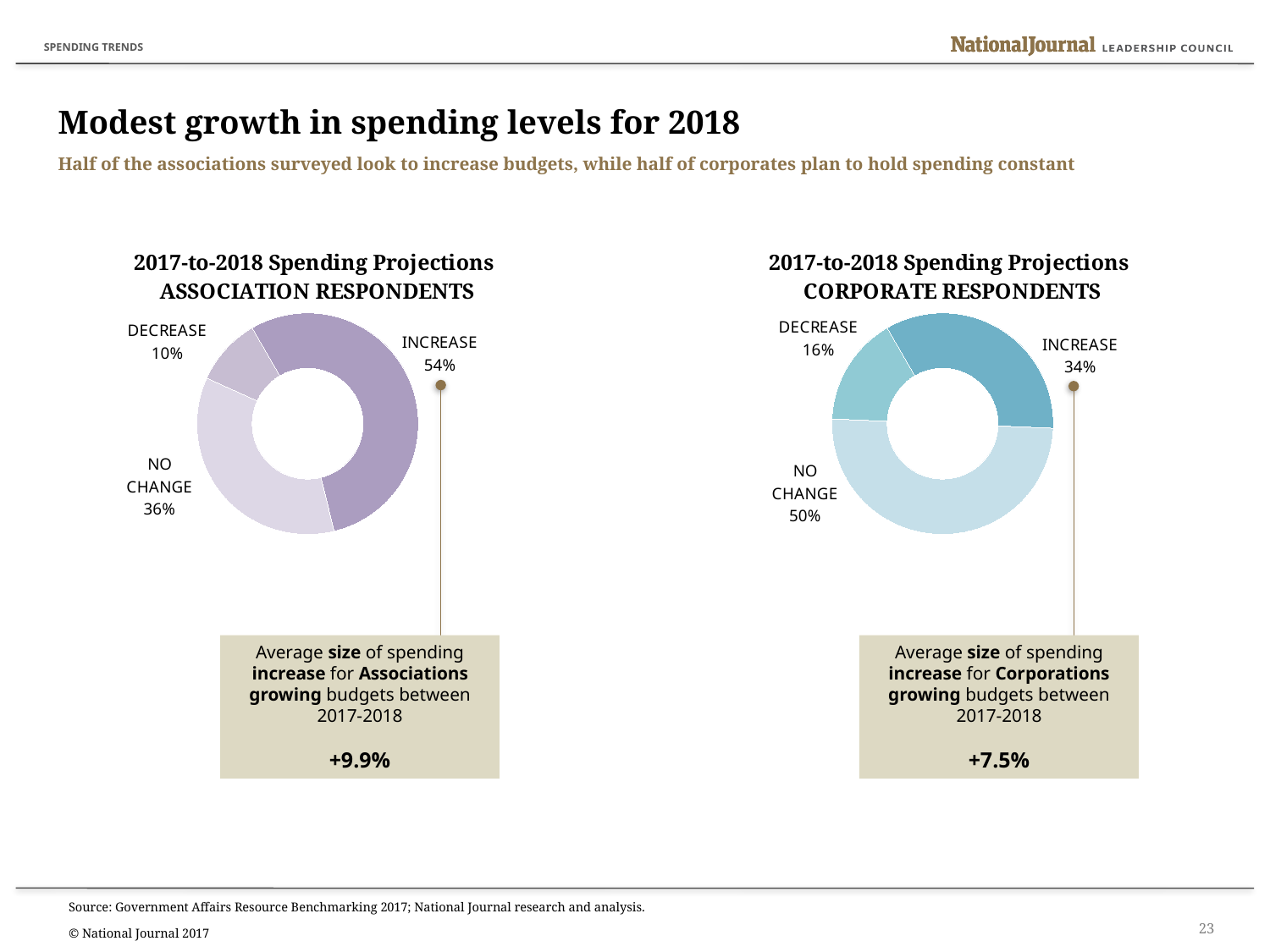
How many categories does the Association Respondents chart show? 3 In the Corporate Respondents chart, what share of respondents project no change in spending? 50% In the Corporate Respondents chart, what is the difference in percentage points between the NO CHANGE and INCREASE shares? 16 What is the average size of spending increase for Associations growing budgets between 2017-2018, as shown below the Association Respondents chart? +9.9% In the Association Respondents chart, what share of respondents project a decrease in spending? 10% In the Corporate Respondents chart, what share of respondents project a decrease in spending? 16% What type of chart is the Corporate Respondents chart? Doughnut chart In the Corporate Respondents chart, which category has the smallest share? DECREASE Which chart shows a larger share for INCREASE, the Association Respondents chart or the Corporate Respondents chart? Association Respondents What is the average size of spending increase for Corporations growing budgets between 2017-2018, as shown below the Corporate Respondents chart? +7.5% In the Association Respondents chart, which category has the largest share? INCREASE In the Association Respondents chart, what share of respondents project an increase in spending? 54%